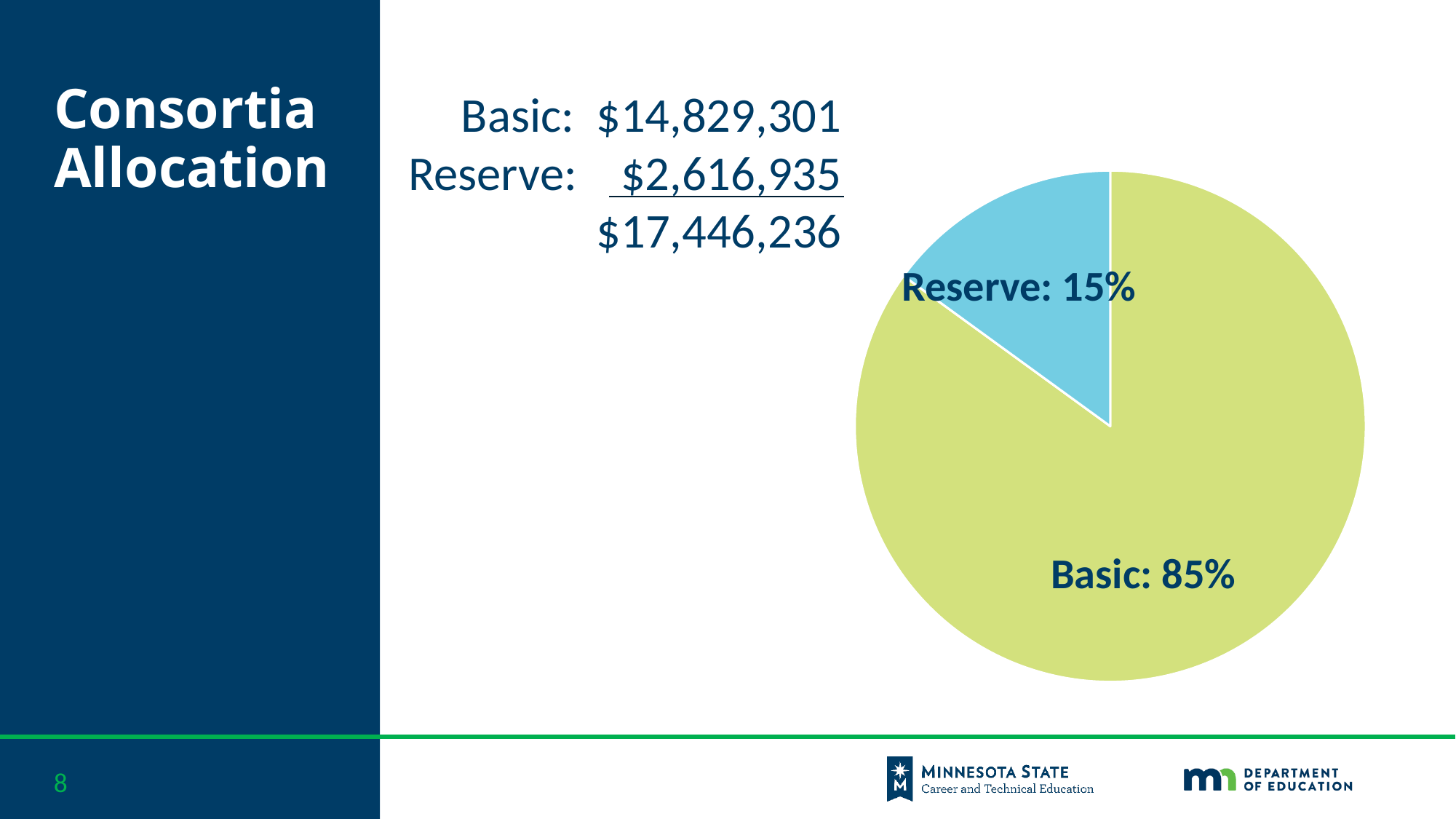
What share of the pie does the Reserve slice represent? 15% Which slice of the pie is the smallest? Reserve What share of the pie does the Basic slice represent? 85% Which slice of the pie is the largest? Basic What colour is the Reserve slice of the pie? blue What is the total allocation shown on the slide? $17,446,236 What is the difference in percentage points between the Basic and Reserve slices? 70 percentage points What dollar amount is shown for Basic on the slide? $14,829,301 How many slices does the pie chart have? 2 What dollar amount is shown for Reserve on the slide? $2,616,935 What kind of chart is shown on the slide? pie chart Which is larger, the Basic slice or the Reserve slice? Basic